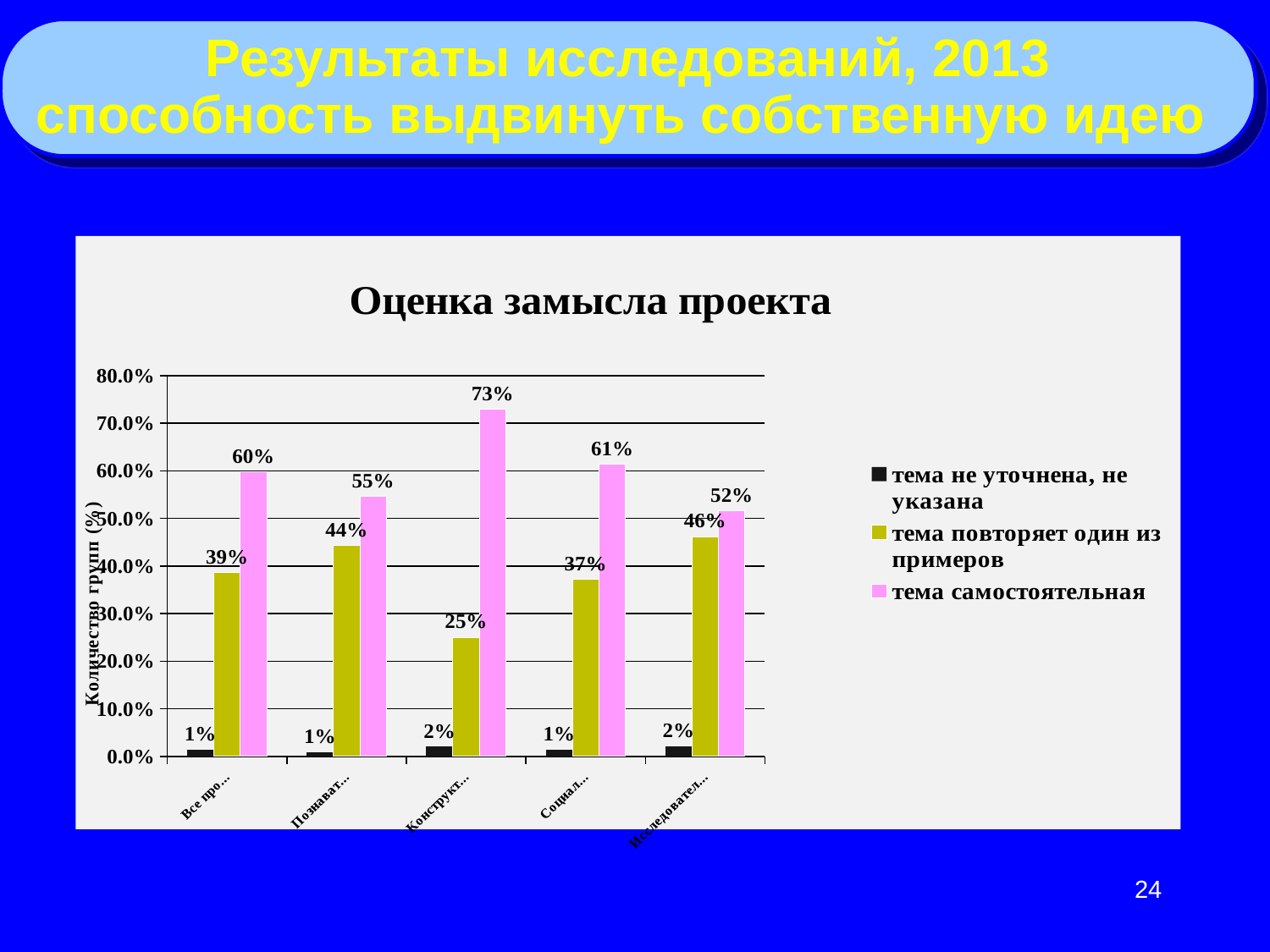
How many categories are shown along the x axis of the chart? 5 Which is larger: 'тема повторяет один из примеров' for the second category ('Познават...') or for the fourth category ('Социал...')? Познават... (second category) What is the title of the chart? Оценка замысла проекта What is the value of 'тема самостоятельная' for the first category ('Все про...')? 60% What type of chart is shown on the slide? bar chart What is the value of 'тема не уточнена, не указана' for the fifth category ('Исследовател...')? 2% How many series does the chart legend list? 3 What is the difference between the 'тема самостоятельная' values for the third category ('Конструкт...') and the fifth category ('Исследовател...')? 21% What is the value of 'тема повторяет один из примеров' for the third category ('Конструкт...')? 25% Which series is shown in pink in the chart? тема самостоятельная Which category has the lowest value for 'тема повторяет один из примеров'? Конструкт... (third category) Which category has the highest value for 'тема самостоятельная'? Конструкт... (third category)